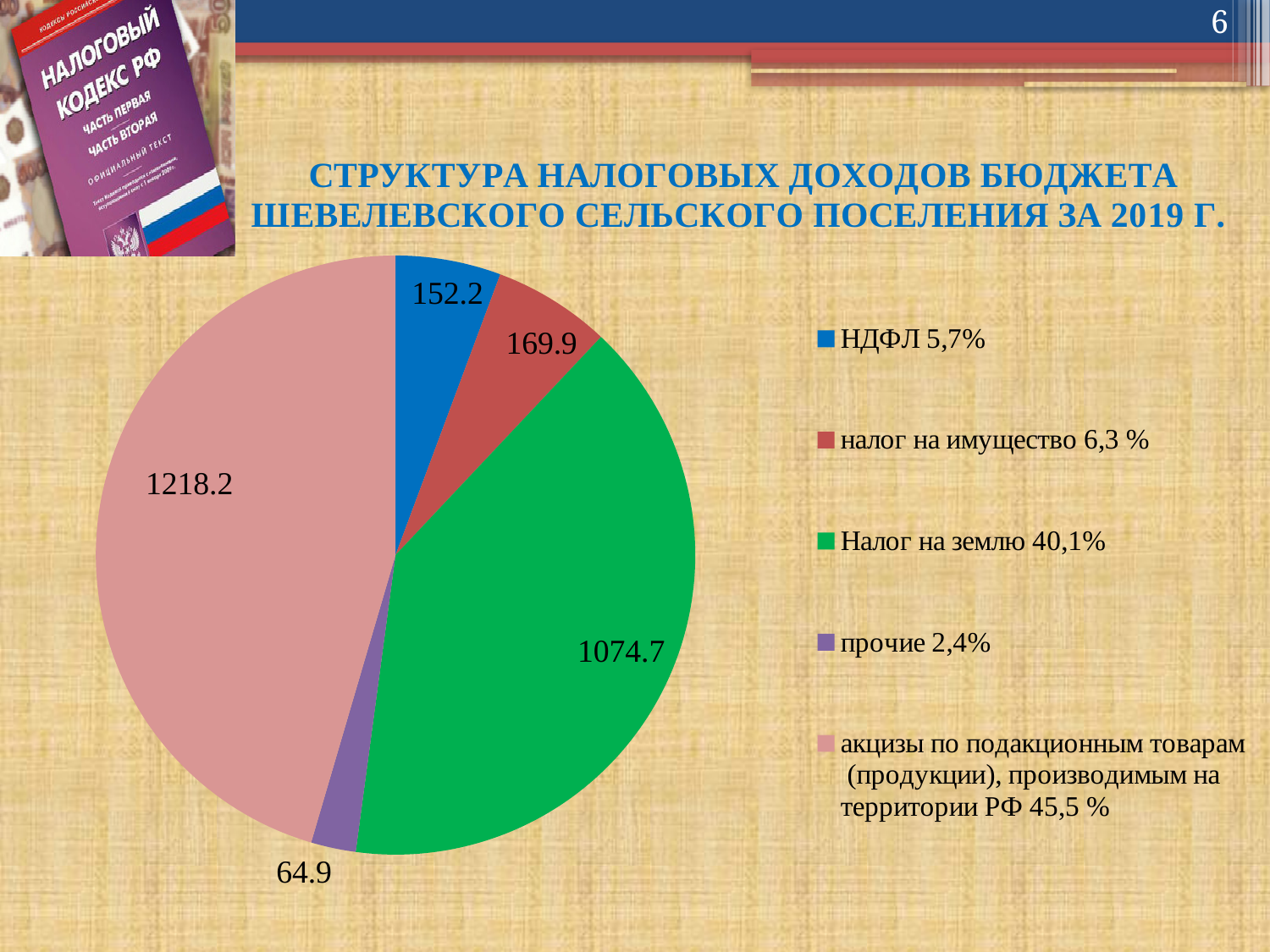
What is the value of the налог на имущество slice? 169.9 What is the value of the прочие slice? 64.9 How many slices does the pie chart have? 5 Which category has the largest slice of the pie? акцизы по подакционным товарам (продукции), производимым на территории РФ What type of chart is shown on the slide? pie chart What is the value of the Налог на землю slice? 1074.7 What is the difference between the акцизы slice (1218.2) and the Налог на землю slice (1074.7)? 143.5 What is the value of the НДФЛ slice? 152.2 Which category has the smallest slice of the pie? прочие What share of the pie does Налог на землю represent, according to the legend? 40,1% Which is larger, the налог на имущество slice or the НДФЛ slice? налог на имущество What colour is the Налог на землю slice? green